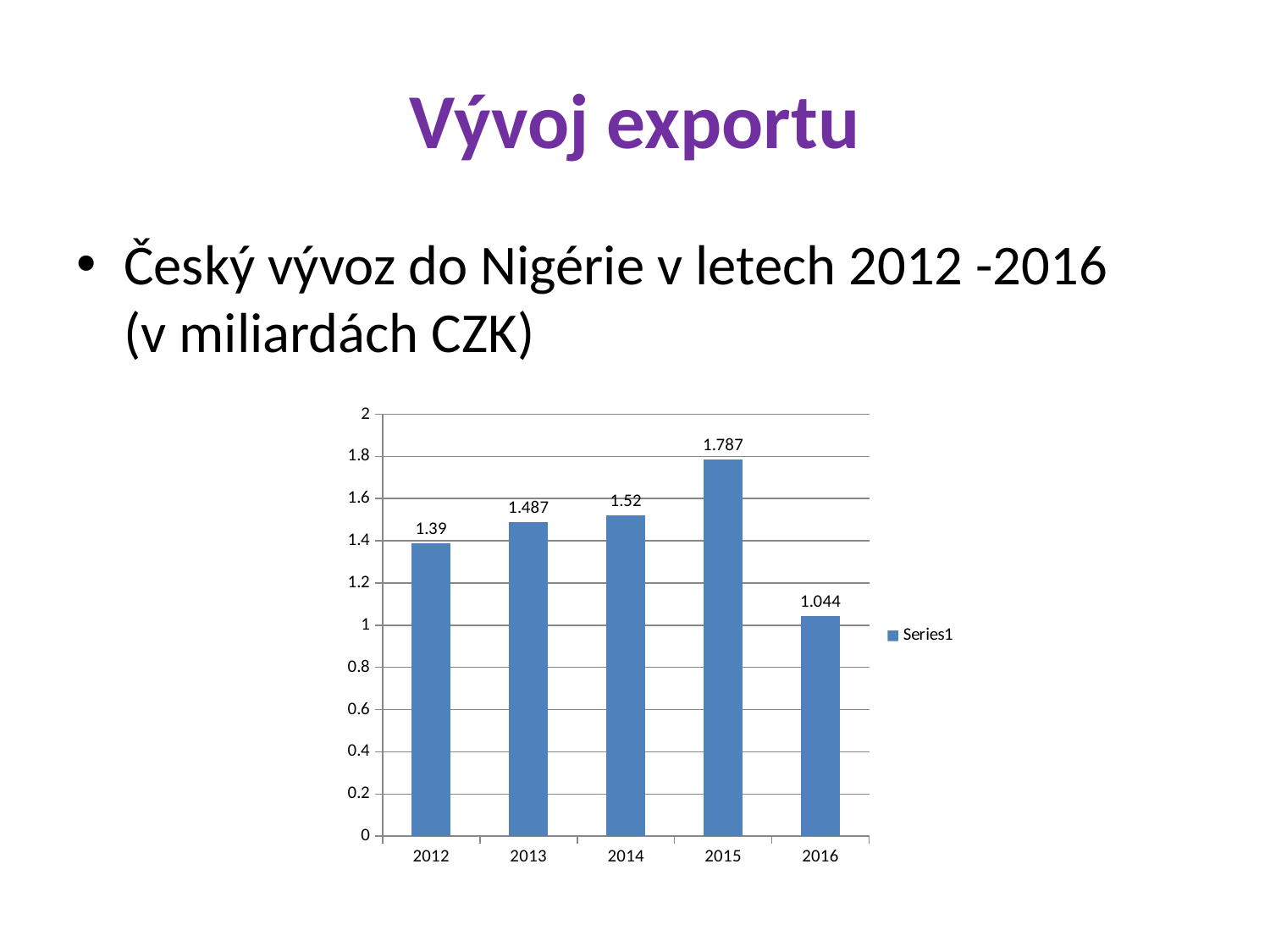
Is the value for 2016 greater or less than 1.2? less What is the value for 2012? 1.39 What is the name of the series listed in the legend? Series1 How many years are shown on the x axis? 5 What is the value for 2016? 1.044 Which year has the lowest value? 2016 Which is larger, the value for 2014 or the value for 2013? 2014 What is the difference between the values for 2015 and 2016? 0.743 Which year has the highest value? 2015 What is the value for 2015? 1.787 What is the difference between the values for 2013 and 2012? 0.097 What kind of chart is shown on the slide? bar chart